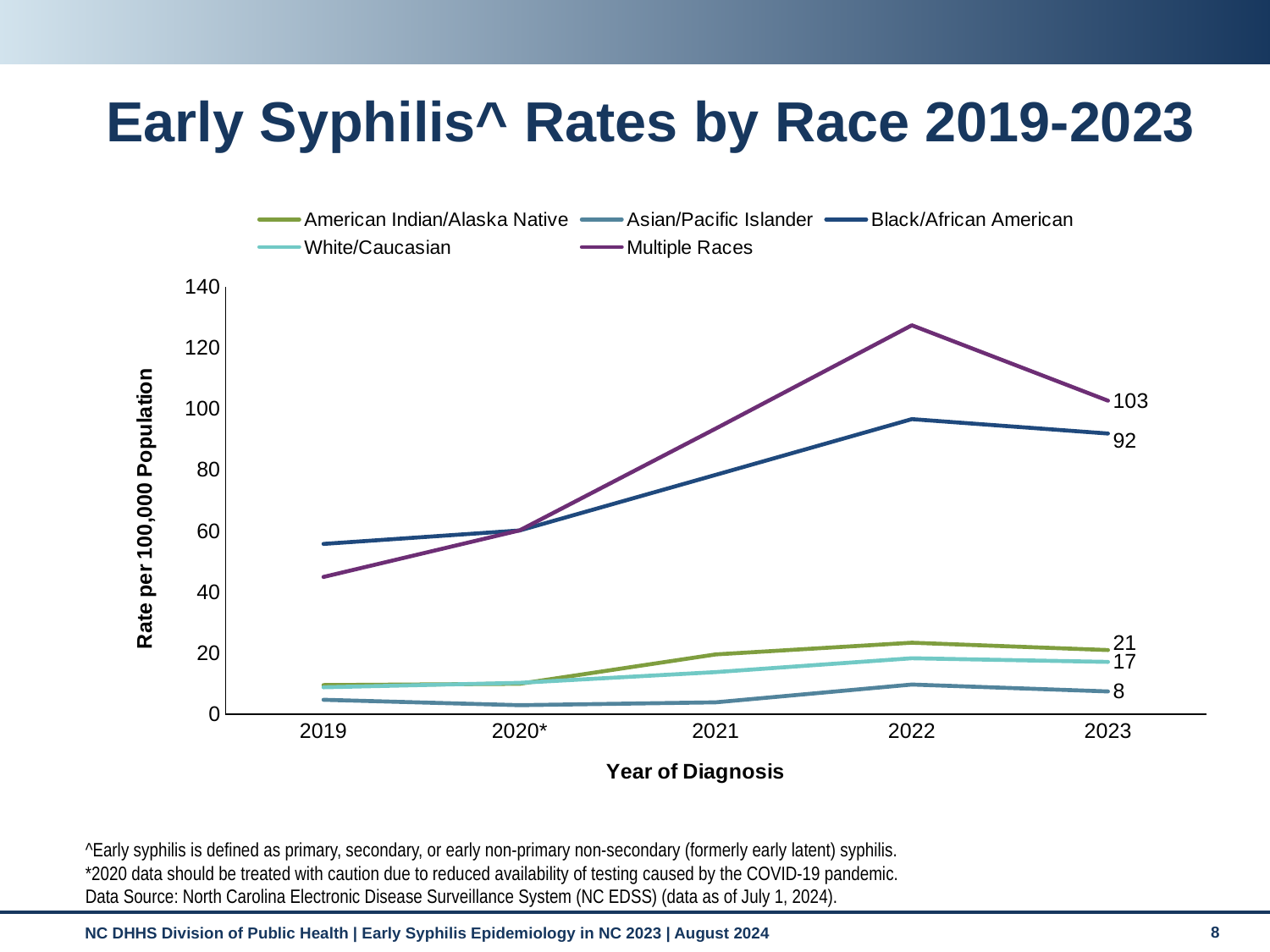
What kind of chart is shown on the slide? Line chart Is the value for Black/African American in 2019 greater or less than 60? less What is the early syphilis rate for Asian/Pacific Islander in 2023? 8 Is the value for Multiple Races in 2022 greater or less than 120? greater In 2023, which is larger: the rate for American Indian/Alaska Native or the rate for White/Caucasian? American Indian/Alaska Native What is the early syphilis rate for Black/African American in 2023? 92 What is the difference between the 2023 rates for Multiple Races and Black/African American? 11 Which race group has the lowest early syphilis rate in 2023? Asian/Pacific Islander What is the early syphilis rate for Multiple Races in 2023? 103 How many series does the legend list? 5 What is the early syphilis rate for White/Caucasian in 2023? 17 Which race group has the highest early syphilis rate in 2023? Multiple Races